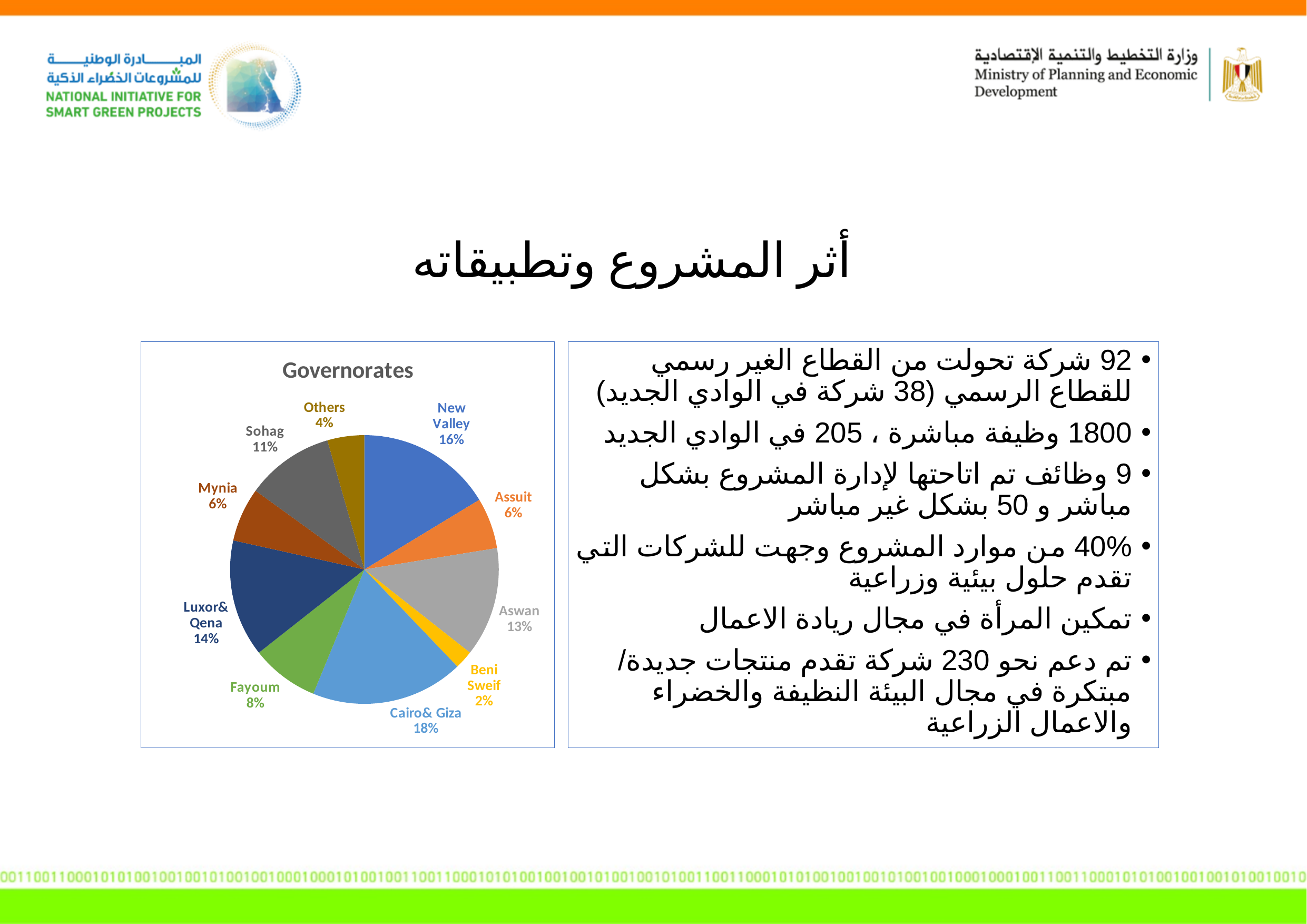
How many slices does the pie chart have? 10 What type of chart is shown on the slide? Pie chart Which governorate has the smallest slice of the pie? Beni Sweif What is the difference between the shares of Luxor& Qena and Fayoum? 6% What is the value shown for New Valley? 16% What is the title of the chart? Governorates What is the difference between the shares of New Valley and Assuit? 10% Which governorate has the largest slice of the pie? Cairo& Giza Which is larger, the share for Sohag or the share for Mynia? Sohag What is the value shown for Others? 4% What share of the pie does Cairo& Giza have? 18% What is the value shown for Aswan? 13%